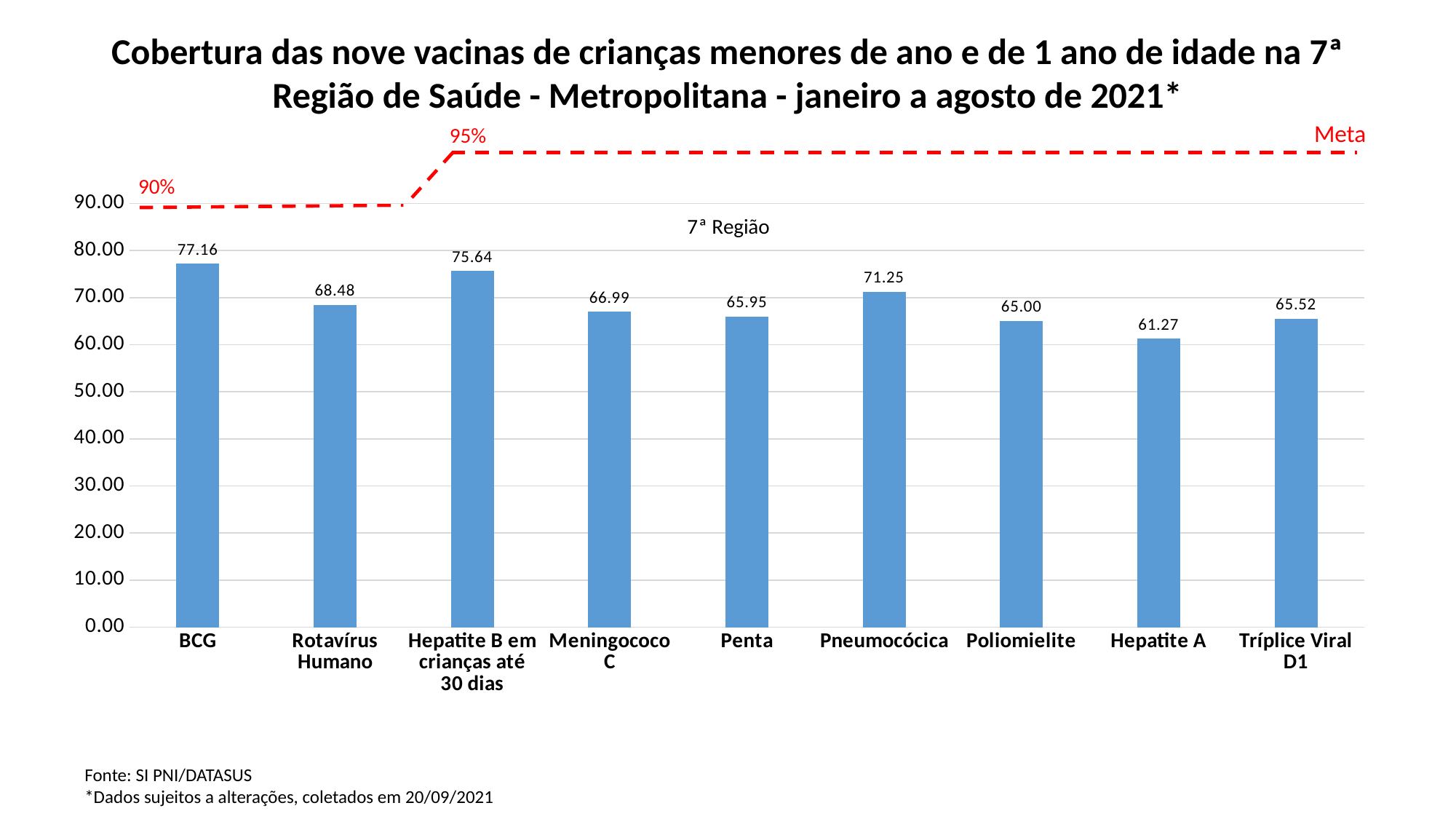
What is the value for BCG? 77.16 Which vaccine has the highest coverage value? BCG How many vaccines are shown on the x axis? 9 What is the value for Pneumocócica? 71.25 What label is shown at the right end of the red dashed line? Meta Which vaccine has the lowest coverage value? Hepatite A What is the value for Hepatite A? 61.27 Is the value for Poliomielite greater or less than 70.00? less What is the difference between the values for BCG and Hepatite A? 15.89 What is the difference between the values for Hepatite B em crianças até 30 dias and Tríplice Viral D1? 10.12 Which is larger, the value for Rotavírus Humano or the value for Meningococo C? Rotavírus Humano What kind of chart is this? bar chart